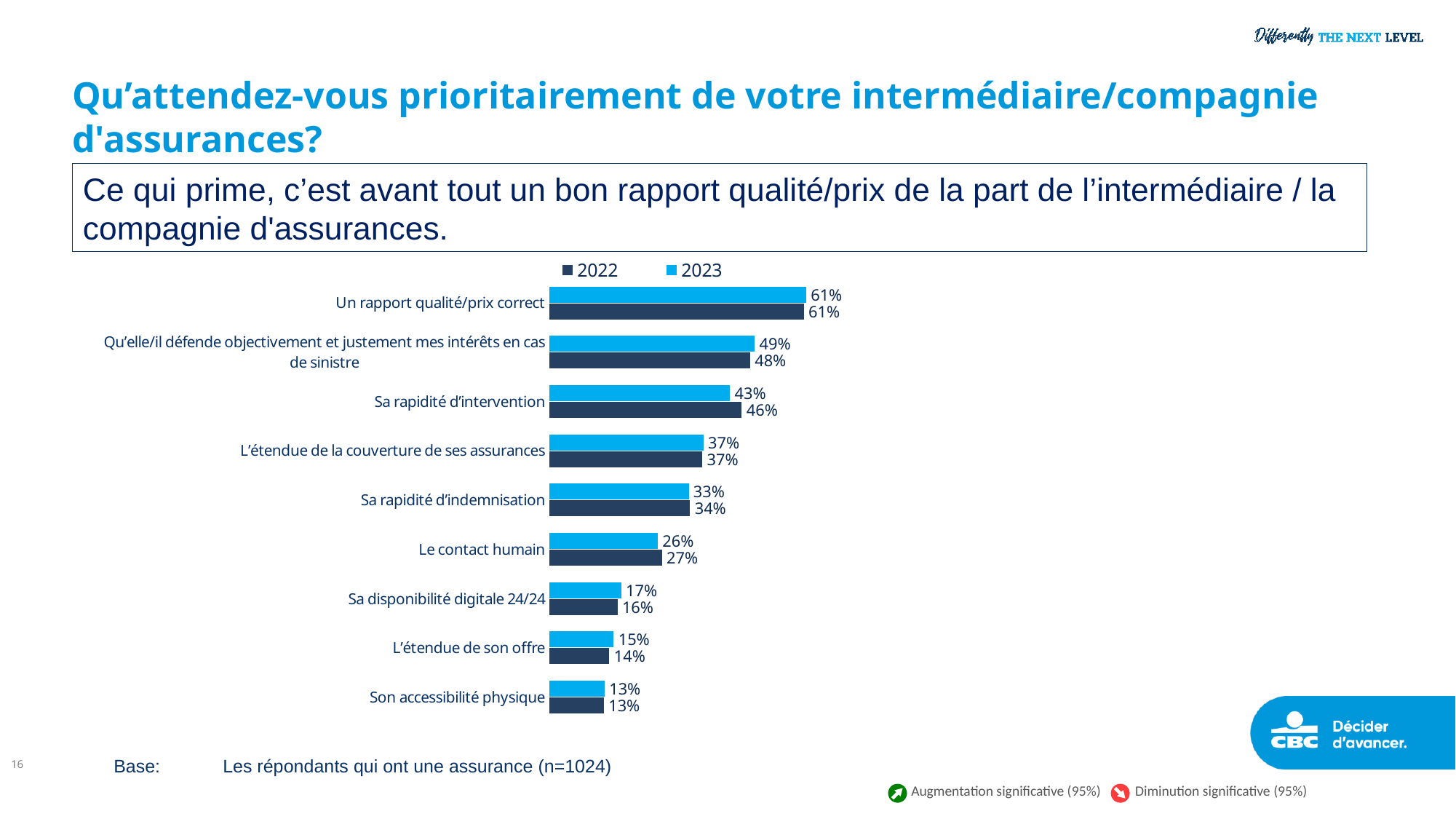
Which category has the highest value in 2023? Un rapport qualité/prix correct What is the difference between the 2022 and 2023 values for "Sa rapidité d'intervention"? 3 percentage points Which is larger for "Qu'elle/il défende objectivement et justement mes intérêts en cas de sinistre": the 2022 value or the 2023 value? 2023 How many series does the legend list? 2 What is the 2022 value for "Sa disponibilité digitale 24/24"? 16% What is the 2022 value for "Sa rapidité d'intervention"? 46% What is the 2023 value for "Le contact humain"? 26% How many categories are shown in the chart? 9 Which category has the lowest value in 2022? Son accessibilité physique Which series is shown in light blue in the legend? 2023 What is the 2023 value for "Sa rapidité d'intervention"? 43% What kind of chart is shown on the slide? Bar chart